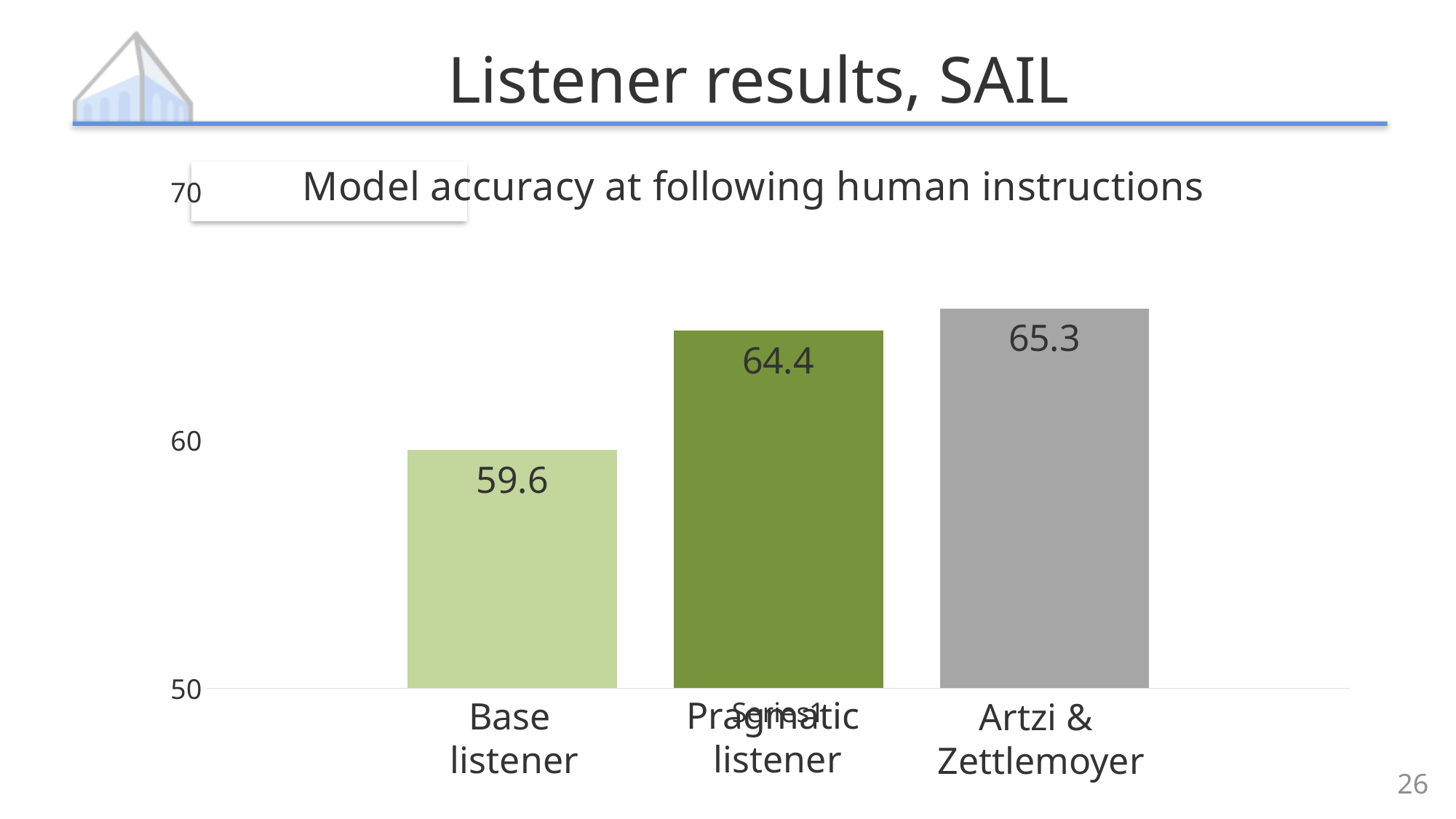
What is the value for Base listener? 59.6 Which is larger, the value for Base listener or the value for Pragmatic listener? Pragmatic listener What is the difference between the values for Pragmatic listener and Base listener? 4.8 What is the difference between the values for Artzi & Zettlemoyer and Pragmatic listener? 0.9 What kind of chart is shown on the slide? bar chart What is the value for Pragmatic listener? 64.4 Is the value for Base listener greater or less than 60? less How many categories are shown in the chart? 3 What is the value for Artzi & Zettlemoyer? 65.3 Which category has the lowest value? Base listener Which category has the highest value? Artzi & Zettlemoyer What is the title of the chart? Model accuracy at following human instructions